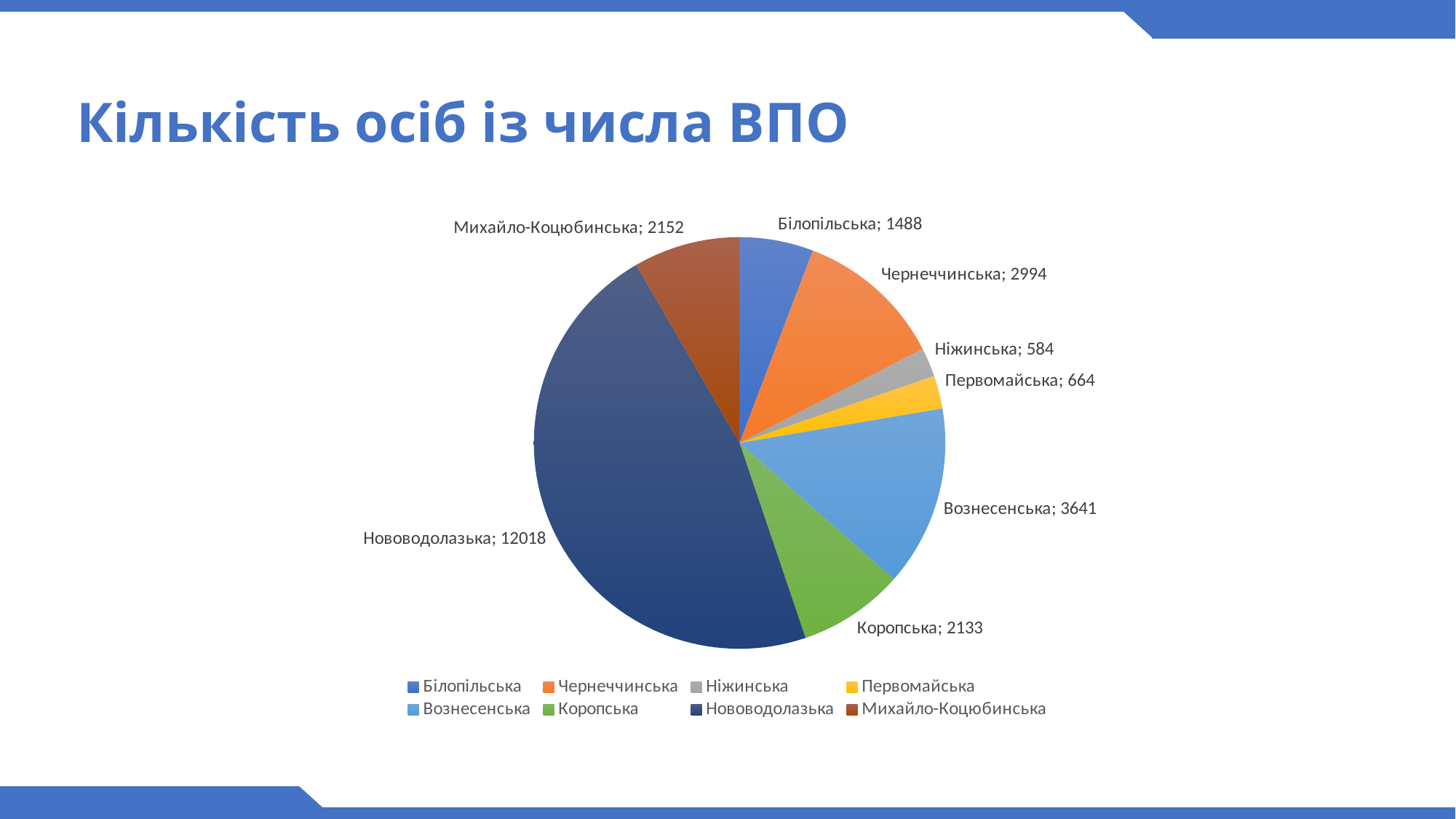
What is the difference between the values for Первомайська and Ніжинська? 80 What is the value for Нововодолазька? 12018 Which category has the largest slice? Нововодолазька What is the title of the slide? Кількість осіб із числа ВПО What is the difference between the values for Вознесенська and Чернеччинська? 647 What kind of chart is shown on the slide? pie chart Which category has the smallest slice? Ніжинська How many categories does the pie chart show? 8 What is the value for Вознесенська? 3641 Which is larger, the value for Михайло-Коцюбинська or the value for Коропська? Михайло-Коцюбинська What is the value for Ніжинська? 584 What is the total of all the slices in the pie chart? 25674